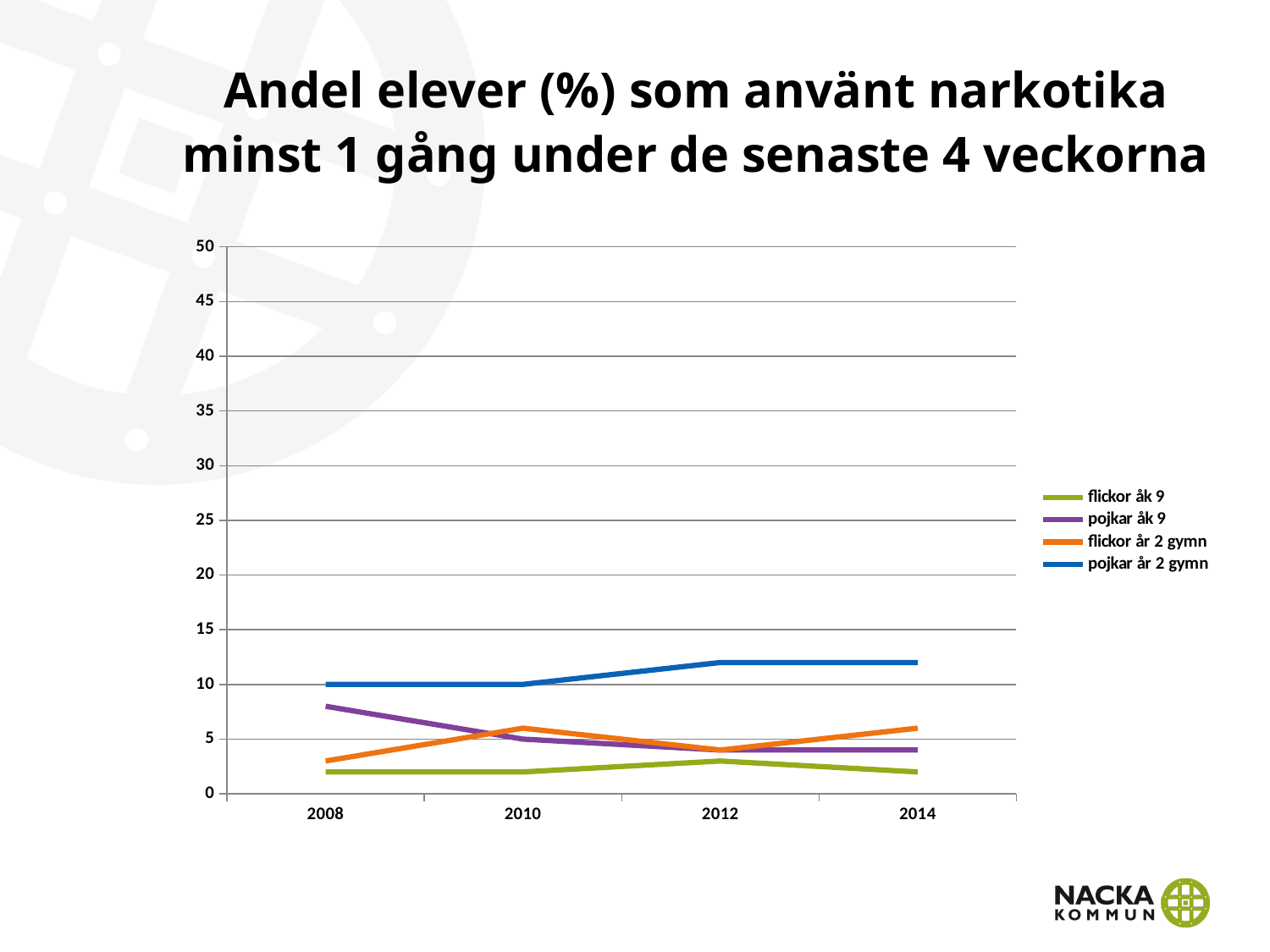
In 2008, which is higher: pojkar åk 9 or flickor åk 9? pojkar åk 9 What kind of chart is shown on the slide? line chart What is the value for pojkar år 2 gymn in 2010? 10 Is the value for pojkar åk 9 in 2008 greater or less than 5? greater What is the value for pojkar år 2 gymn in 2008? 10 Is the value for flickor åk 9 in 2008 greater or less than 5? less Which series has the lowest value in 2014? flickor åk 9 Is the value for pojkar år 2 gymn in 2014 greater or less than 10? greater How many years are shown on the x axis? 4 How many series does the legend list? 4 Does the value for pojkar åk 9 rise or fall from 2008 to 2012? fall Which series has the highest value in 2014? pojkar år 2 gymn